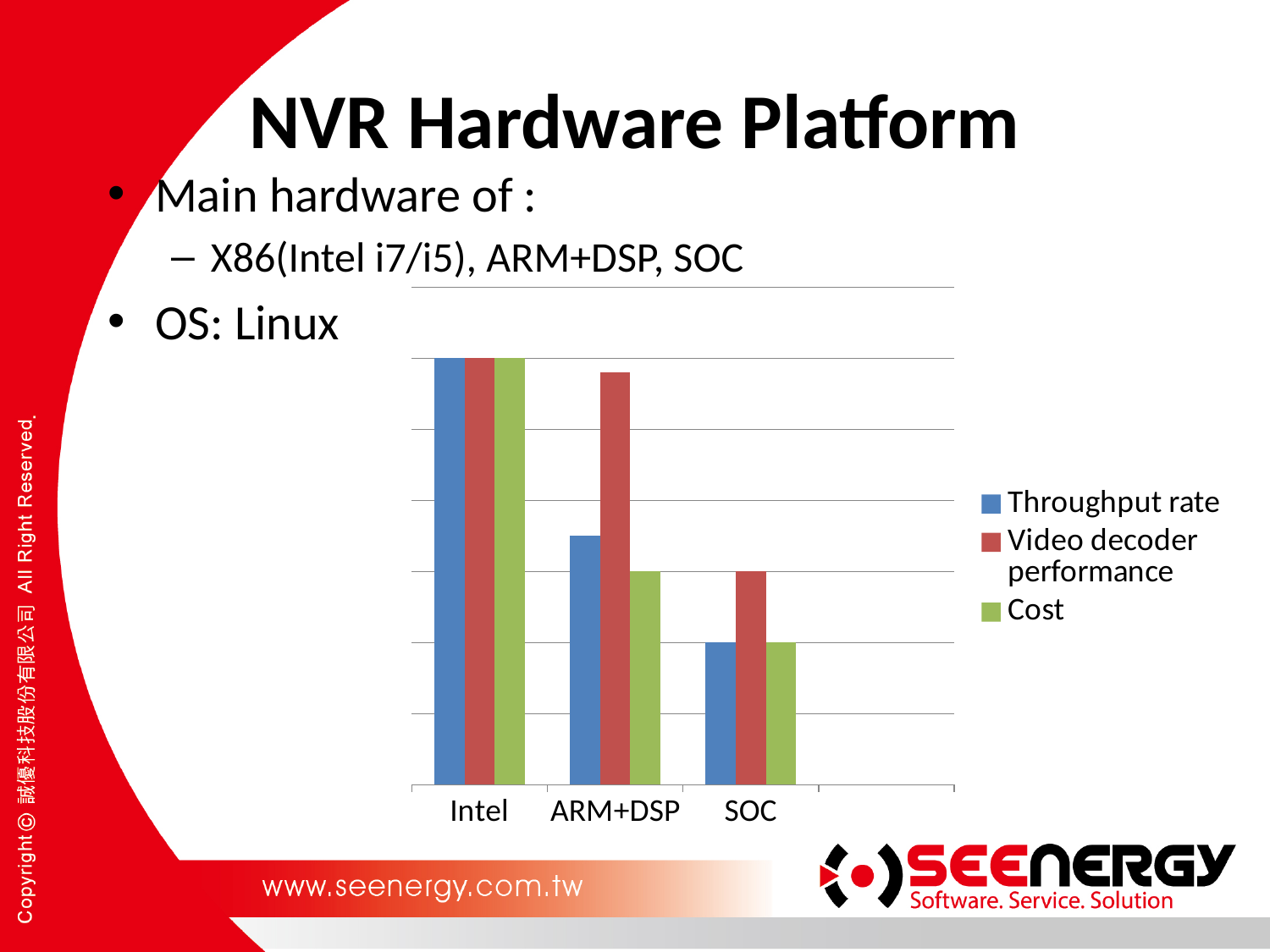
Which category has the lowest Cost? SOC Which is larger, the Throughput rate for ARM+DSP or for SOC? ARM+DSP Which series has the tallest bar for SOC? Video decoder performance What kind of chart is shown on the slide? Bar chart How many hardware platform categories are shown on the x axis of the chart? 3 Which category has the lowest Throughput rate? SOC Which is larger, the Video decoder performance for Intel or for ARM+DSP? Intel What are the three series listed in the chart's legend? Throughput rate, Video decoder performance, Cost Does the Throughput rate rise or fall moving from Intel to ARM+DSP to SOC? Fall Which category has the highest Throughput rate? Intel Which is larger, the Cost for ARM+DSP or for SOC? ARM+DSP How many series does the chart's legend list? 3